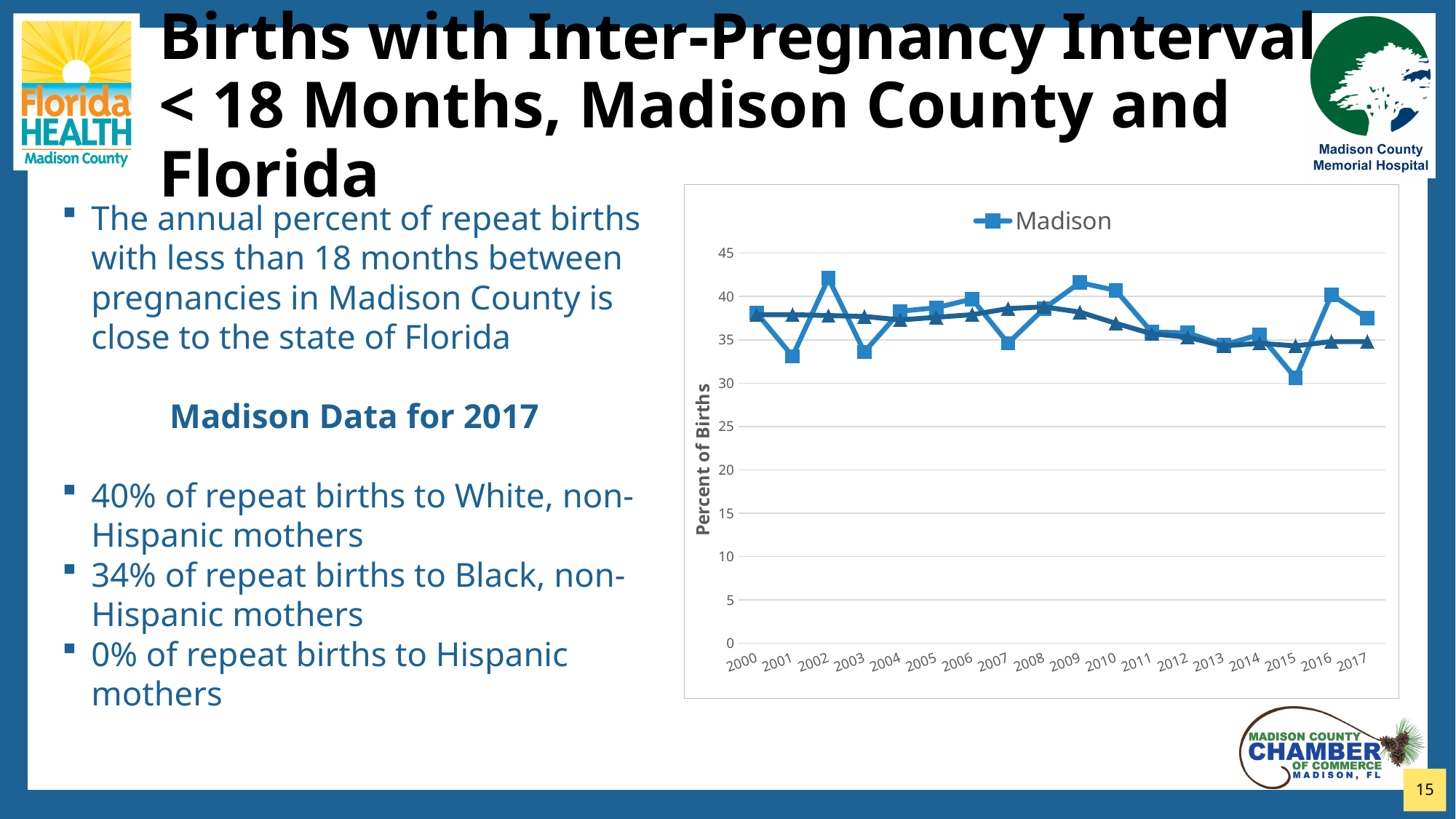
Is the Madison value for 2009 greater or less than 40? greater How many years are shown along the x axis of the chart? 18 Is the Madison value for 2001 greater or less than 35? less How many series does the chart's legend list? 1 Is the Madison value for 2002 greater or less than 40? greater What is the label on the vertical axis of the chart? Percent of Births Which year has the larger Madison value, 2001 or 2002? 2002 What kind of chart is shown on the slide? line chart What series name appears in the chart's legend? Madison In which year is the Madison value lowest? 2015 Does the Madison value rise or fall from 2009 to 2015? fall